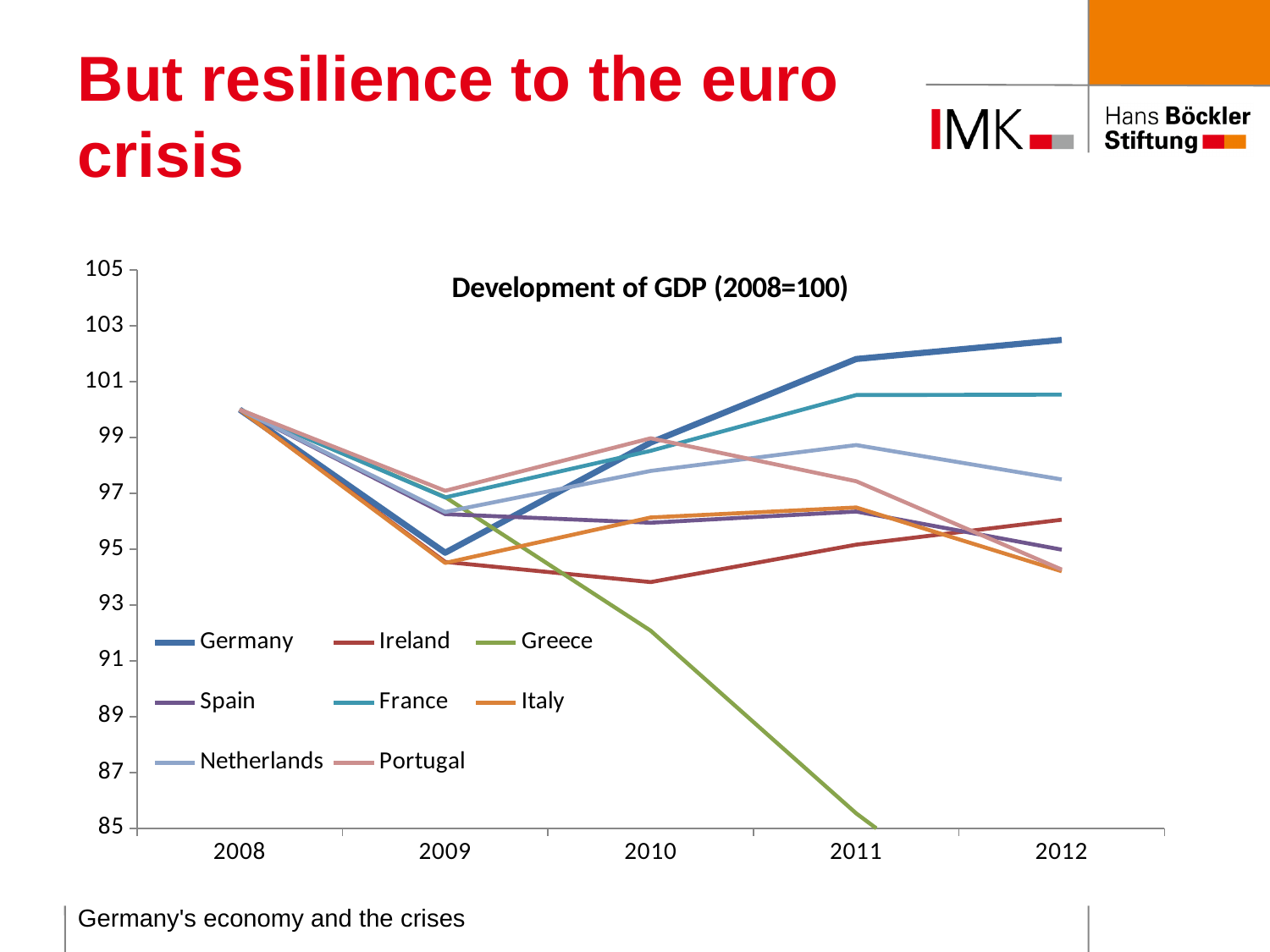
Is the value for Greece in 2010 greater or less than 93? less Which is higher in 2012, Germany or France? Germany Which country has the lowest GDP index in 2010? Greece Which country has the highest GDP index in 2012? Germany How many years are shown on the x axis? 5 What is the title of the chart? Development of GDP (2008=100) Is the value for Ireland in 2010 greater or less than 95? less Is the value for Germany in 2012 greater or less than 101? greater How many series does the legend list? 8 What kind of chart is shown on the slide? line chart Does the Germany line rise or fall from 2009 to 2012? rises Does the Greece line rise or fall from 2008 to 2011? falls